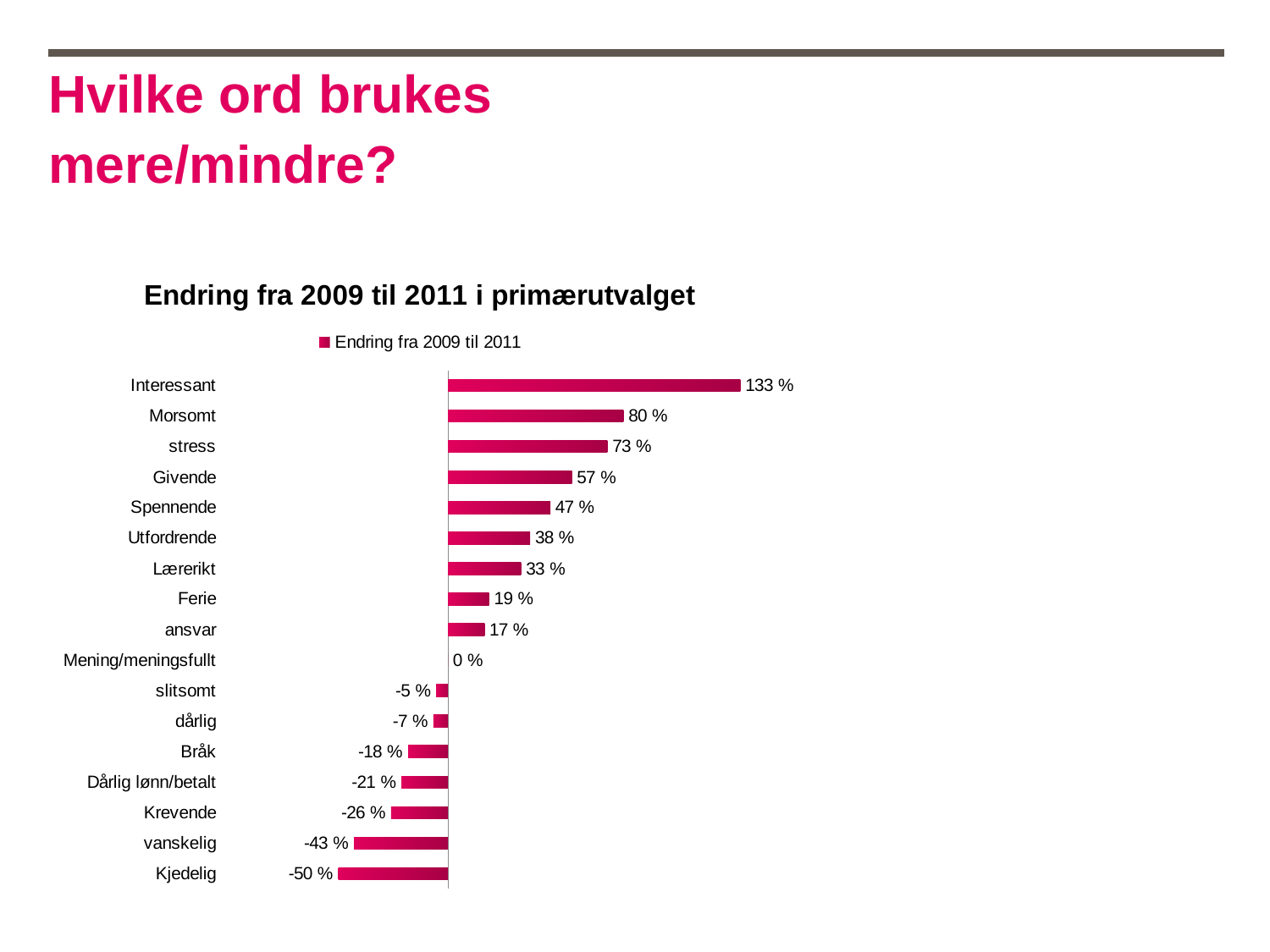
What is the title of the chart? Endring fra 2009 til 2011 i primærutvalget Which category has the highest value? Interessant Which is larger, the value for Givende or the value for Spennende? Givende Which category has the lowest value? Kjedelig What is the difference between the values for Morsomt and stress? 7 % What is the value for Ferie? 19 % How many series does the legend list? 1 What kind of chart is shown on the slide? Bar chart What is the value for Dårlig lønn/betalt? -21 % What is the value for Kjedelig? -50 % How many categories are shown in the chart? 17 What is the value for Interessant? 133 %